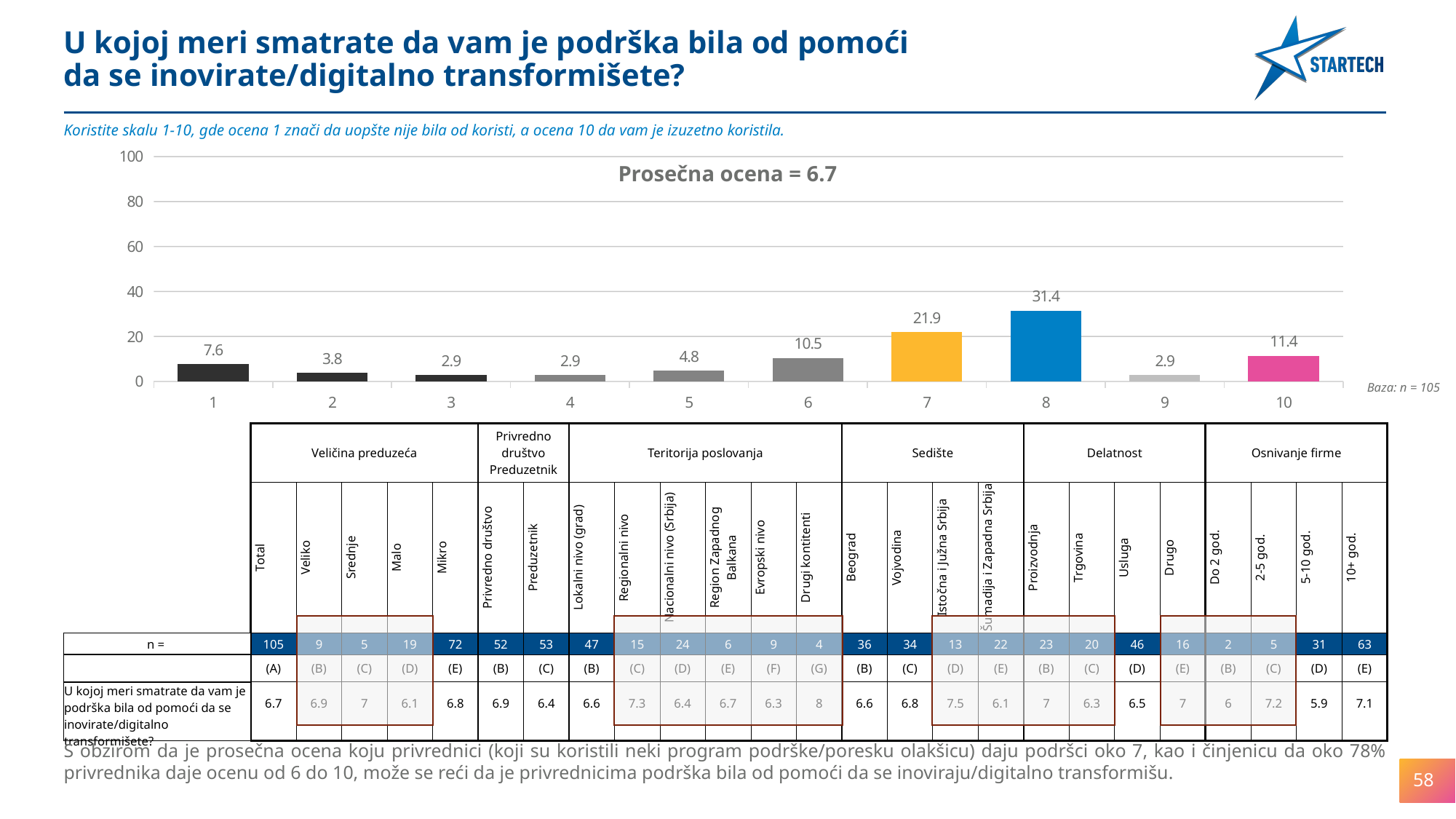
What is the value for rating 8 in the bar chart? 31.4 What is the difference between the values for rating 1 and rating 2? 3.8 What is the difference between the values for rating 8 and rating 7? 9.5 What is the base size (Baza) shown next to the chart? n = 105 What kind of chart is shown on the slide? bar chart What is the value for rating 10 in the bar chart? 11.4 Which rating has the highest value in the bar chart? 8 Which is larger, the value for rating 6 or the value for rating 10? 10 Is the value for rating 7 greater or less than 20? greater How many rating categories are shown on the x axis of the bar chart? 10 What is the value for rating 1 in the bar chart? 7.6 What is the average score (Prosečna ocena) shown in the chart title? 6.7